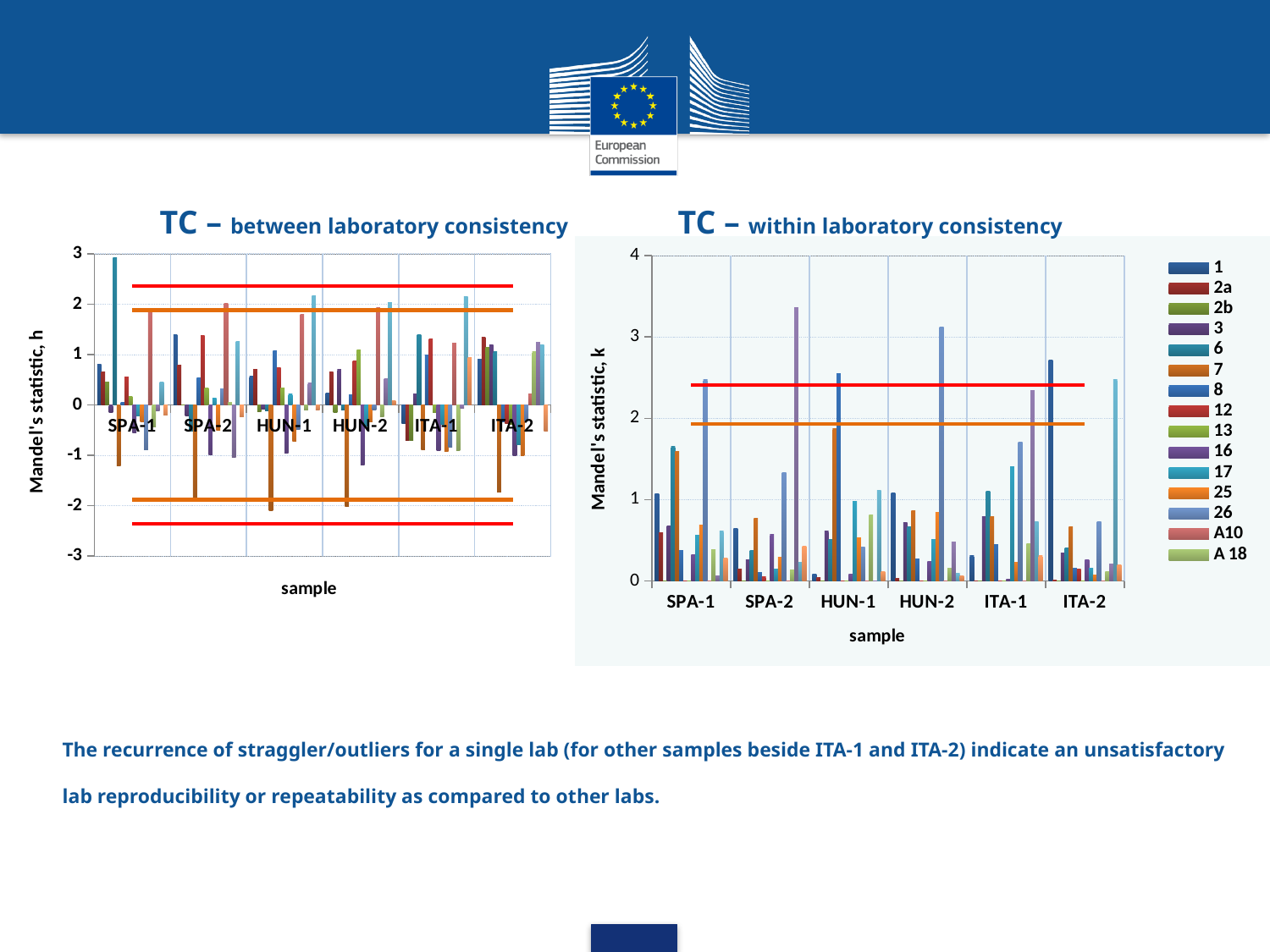
What kind of chart is the 'TC – between laboratory consistency' chart on the left? bar chart What kind of chart is the 'TC – within laboratory consistency' chart on the right? bar chart In the 'TC – within laboratory consistency' chart, is the tallest bar for SPA-2 greater or less than 3? greater What is the y-axis title of the 'TC – between laboratory consistency' chart? Mandel's statistic, h How many sample categories are shown on the x axis of the 'TC – within laboratory consistency' chart? 6 What is the y-axis title of the 'TC – within laboratory consistency' chart? Mandel's statistic, k How many sample categories are shown on the x axis of the 'TC – between laboratory consistency' chart? 6 In the 'TC – between laboratory consistency' chart, is the tallest bar for SPA-1 greater or less than 2? greater In the 'TC – within laboratory consistency' chart, is the tallest bar for ITA-2 greater or less than 2? greater How many series does the legend of the 'TC – within laboratory consistency' chart list? 15